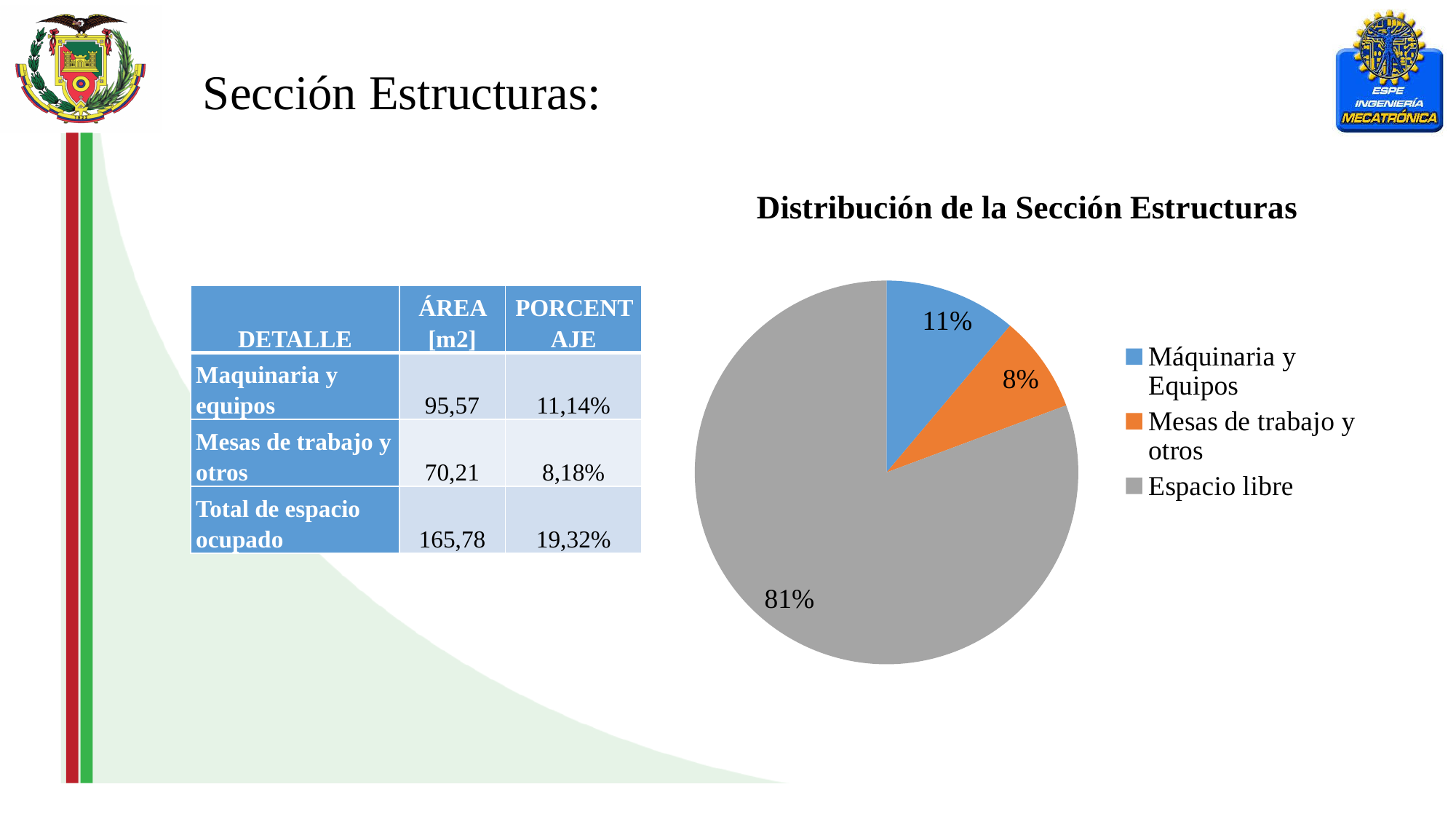
Which category has the largest slice of the pie? Espacio libre Which is larger: the slice for Máquinaria y Equipos or the slice for Mesas de trabajo y otros? Máquinaria y Equipos What is the title of the chart? Distribución de la Sección Estructuras What is the difference in percentage points between the Espacio libre slice and the Máquinaria y Equipos slice? 70% What kind of chart is shown on the slide? pie chart What is the combined share of Máquinaria y Equipos and Mesas de trabajo y otros? 19% How many categories does the pie chart show? 3 What share of the pie does Mesas de trabajo y otros take? 8% What colour is the Espacio libre slice? grey What share of the pie does Máquinaria y Equipos take? 11% Which category has the smallest slice of the pie? Mesas de trabajo y otros What share of the pie does Espacio libre take? 81%